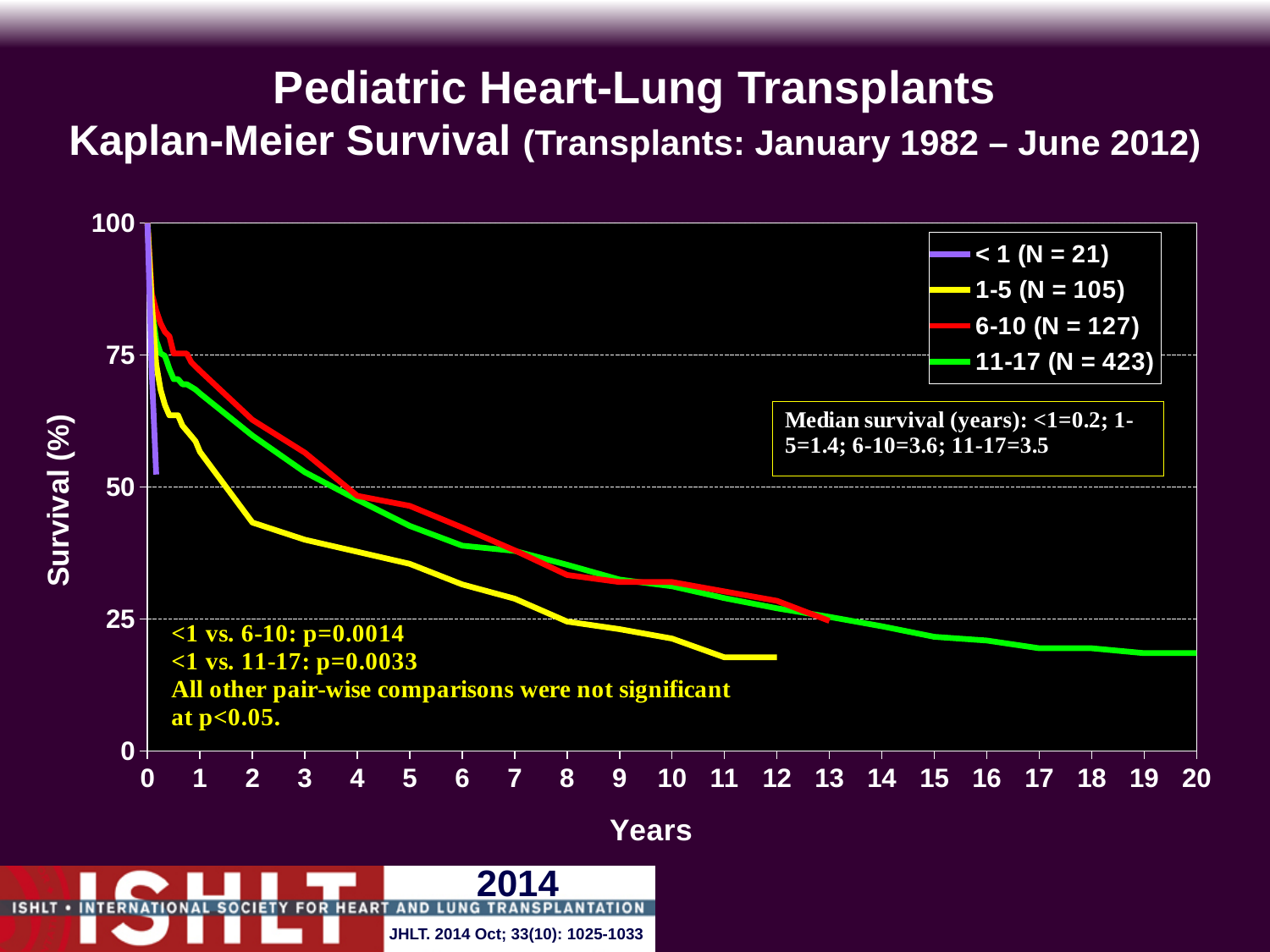
How many series does the legend list? 4 What kind of chart is shown on the slide? line chart Is the survival value for the 1-5 group at year 5 greater or less than 50? less Is the survival value for the 11-17 group at year 20 greater or less than 25? less Do the survival curves rise or fall as years increase along the x axis? fall What p-value is given for the comparison of <1 vs. 6-10? p=0.0014 Which age group has the largest N in the legend? 11-17 What is the difference between the median survival of the 6-10 group and the 11-17 group, in years? 0.1 What is the median survival in years for the 6-10 group? 3.6 At year 2, which group has higher survival, 1-5 or 6-10? 6-10 What is the N for the 11-17 age group in the legend? 423 Which age group has the smallest N in the legend? < 1